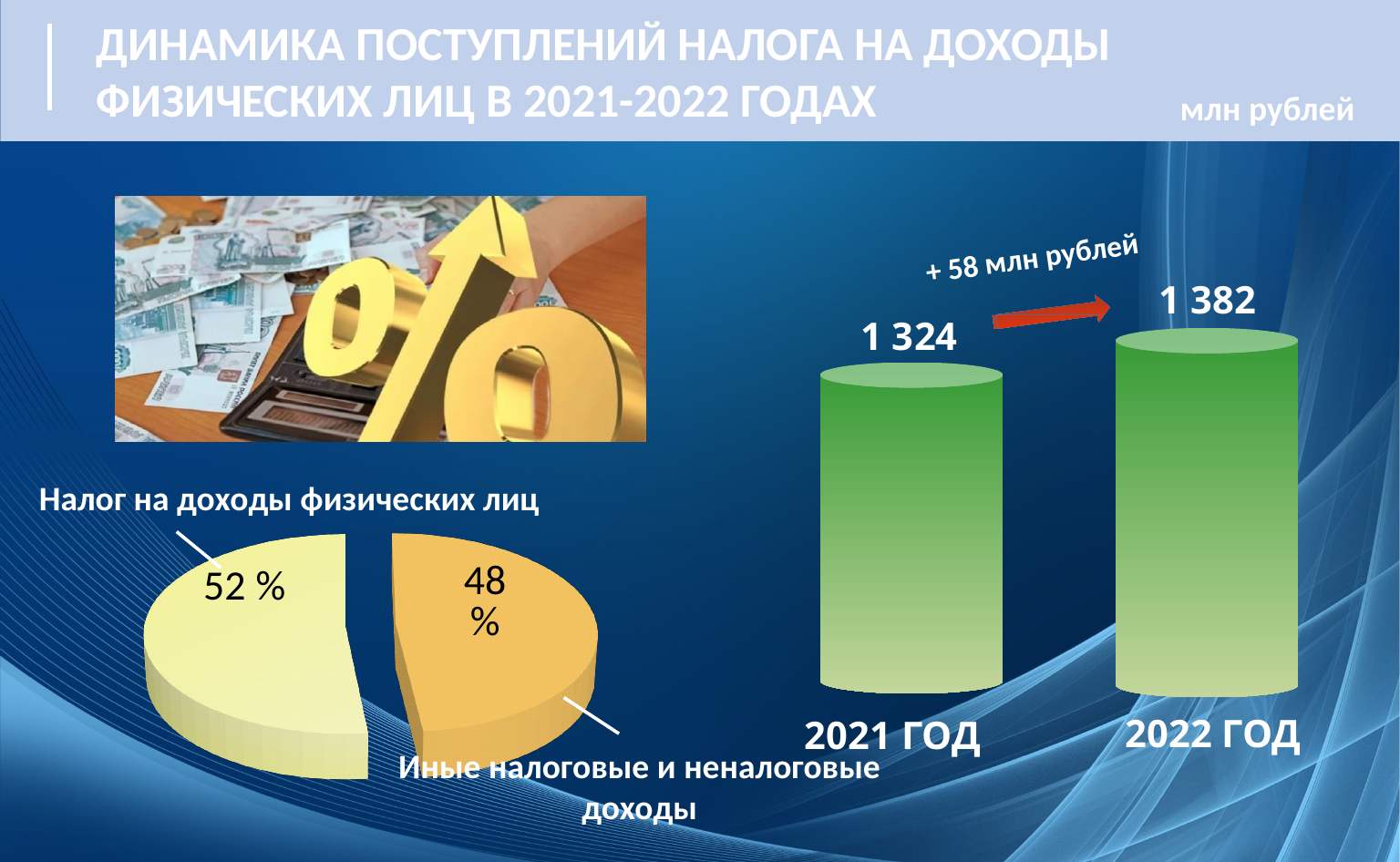
On the bar chart on the right, what is the value for 2021 ГОД? 1 324 On the bar chart on the right, do the values rise or fall from 2021 to 2022? rise On the bar chart on the right, how many bars are shown? 2 On the bar chart on the right, what is the difference between the 2022 and 2021 values? 58 What kind of chart is shown on the right side of the slide? bar chart On the pie chart at the bottom left, what share is labelled for Иные налоговые и неналоговые доходы? 48 % On the pie chart at the bottom left, what share is labelled for Налог на доходы физических лиц? 52 % On the bar chart on the right, which year has the higher value? 2022 ГОД On the bar chart on the right, what is the value for 2022 ГОД? 1 382 On the pie chart at the bottom left, which slice is larger? Налог на доходы физических лиц On the bar chart on the right, which year has the lower value? 2021 ГОД In what units are the values on the bar chart on the right given, according to the slide? млн рублей